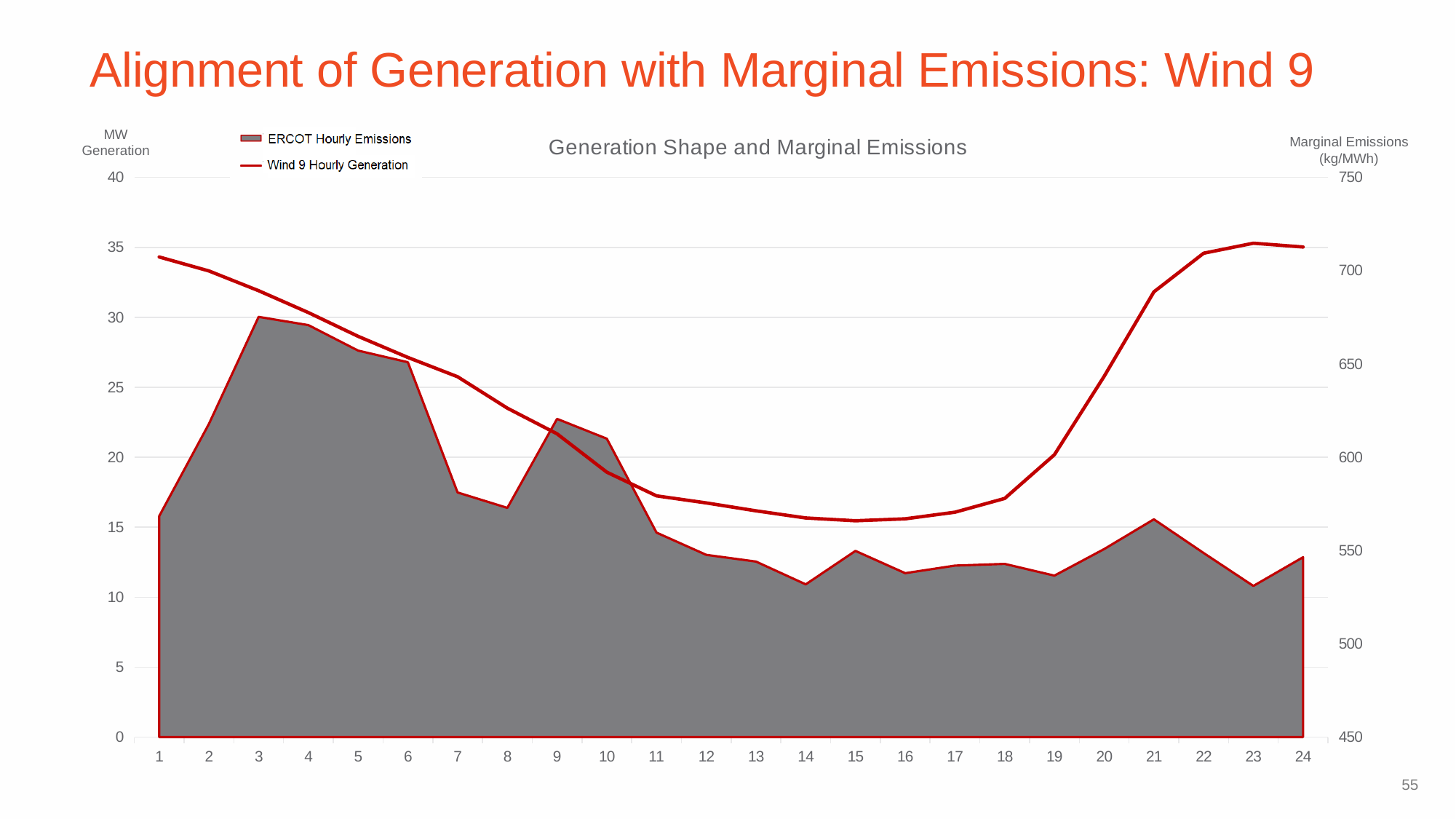
Read against the left axis, is the gray area's value at hour 3 greater or less than 25? greater Read against the left axis, is the red line's value at hour 15 greater or less than 20? less What kind of chart is shown on the slide? A combined area and line chart Read against the left axis, is the gray area's value at hour 14 greater or less than 15? less Which series is drawn as the gray shaded area? ERCOT Hourly Emissions Does the red Wind 9 Hourly Generation line rise or fall from hour 1 to hour 15? Fall How many series does the chart legend list? 2 Does the red Wind 9 Hourly Generation line rise or fall from hour 15 to hour 24? Rise At which hour does the gray ERCOT Hourly Emissions area reach its highest point? 3 How many hours (points) are shown along the x axis? 24 What is the title of the chart? Generation Shape and Marginal Emissions